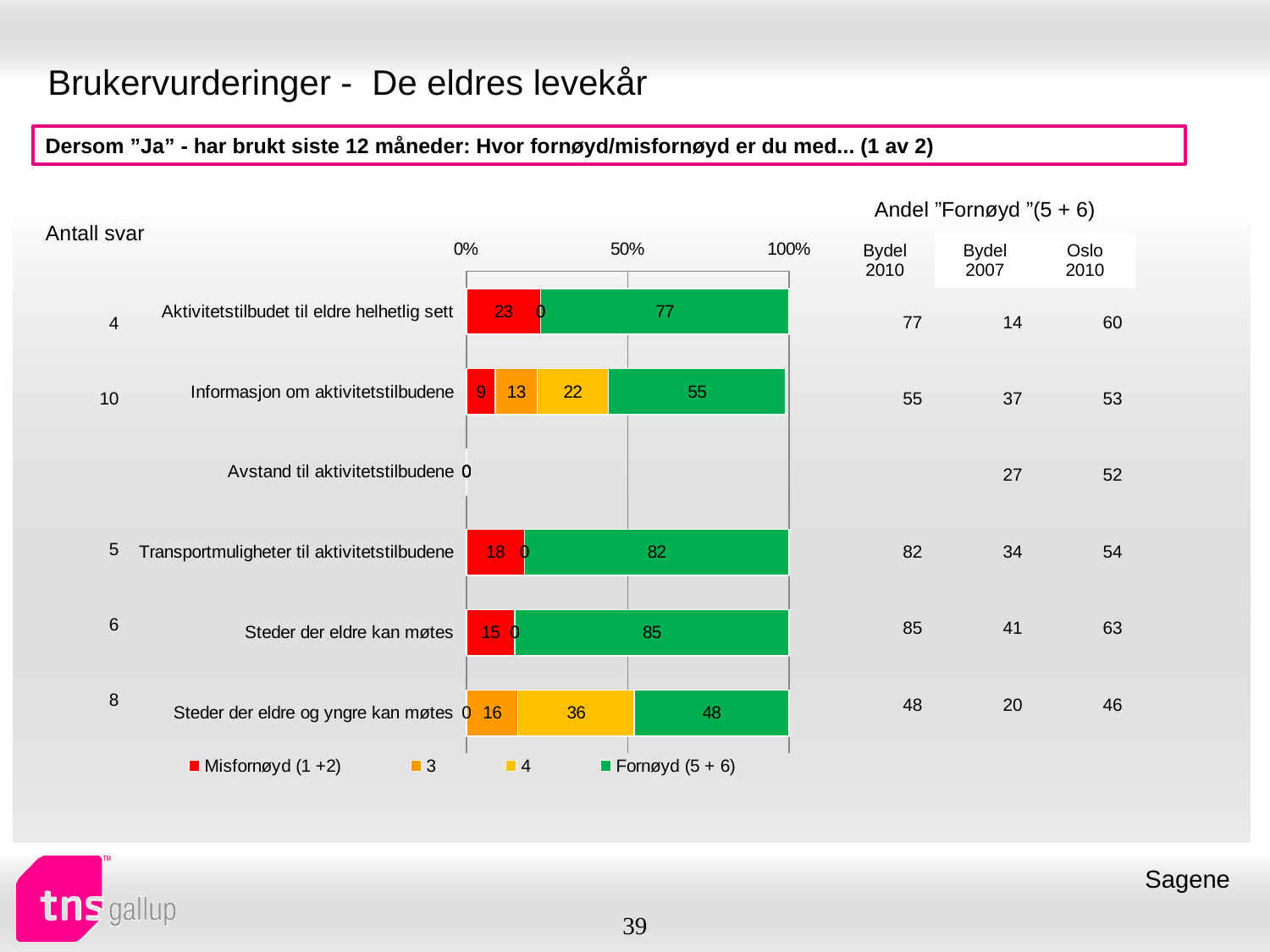
Which category has the highest Fornøyd (5 + 6) value? Steder der eldre kan møtes Which category has the lowest Fornøyd (5 + 6) value among those with a plotted bar? Steder der eldre og yngre kan møtes What is the value of series 4 for Steder der eldre og yngre kan møtes? 36 How many series does the chart legend list? 4 What is the difference between the Fornøyd (5 + 6) values for Transportmuligheter til aktivitetstilbudene and Informasjon om aktivitetstilbudene? 27 What is the Fornøyd (5 + 6) value for Steder der eldre kan møtes? 85 What colour represents the Fornøyd (5 + 6) series in the chart? green Which is larger: the Misfornøyd (1 +2) value for Aktivitetstilbudet til eldre helhetlig sett or for Steder der eldre kan møtes? Aktivitetstilbudet til eldre helhetlig sett How many categories are plotted on the chart? 6 What kind of chart is shown on the slide? stacked bar chart What is the value of series 3 for Informasjon om aktivitetstilbudene? 13 What is the Misfornøyd (1 +2) value for Aktivitetstilbudet til eldre helhetlig sett? 23